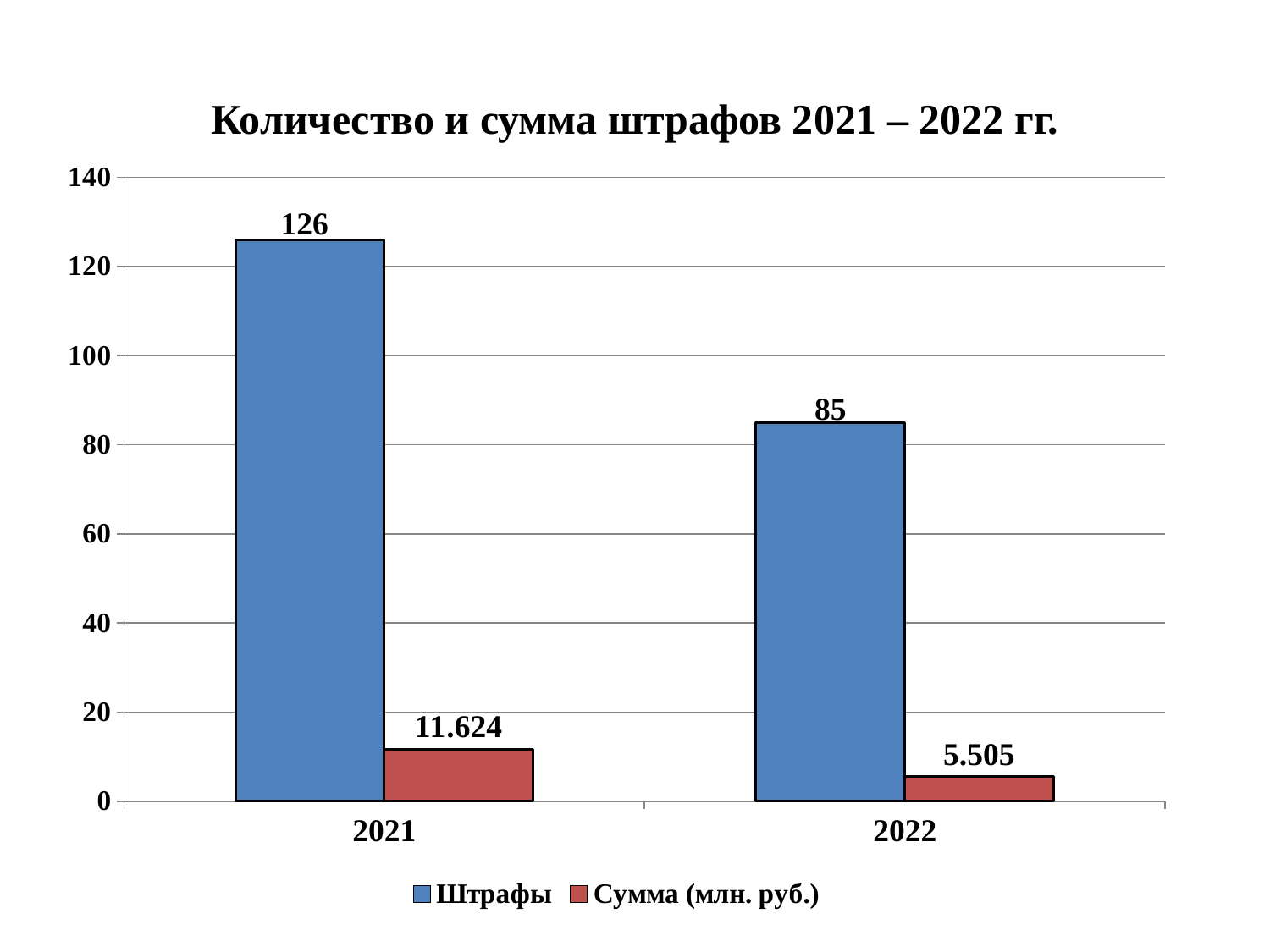
Is the Штрафы value for 2022 greater or less than 100? less How many series does the legend list? 2 Which year has the higher value for Штрафы? 2021 Which year has the lower value for Сумма (млн. руб.)? 2022 How many years are shown on the x axis? 2 What is the title of the chart? Количество и сумма штрафов 2021 – 2022 гг. What is the value of Штрафы for 2021? 126 What is the value of Сумма (млн. руб.) for 2021? 11.624 What is the value of Сумма (млн. руб.) for 2022? 5.505 What kind of chart is shown on the slide? bar chart What is the difference between the Штрафы values for 2021 and 2022? 41 What is the value of Штрафы for 2022? 85